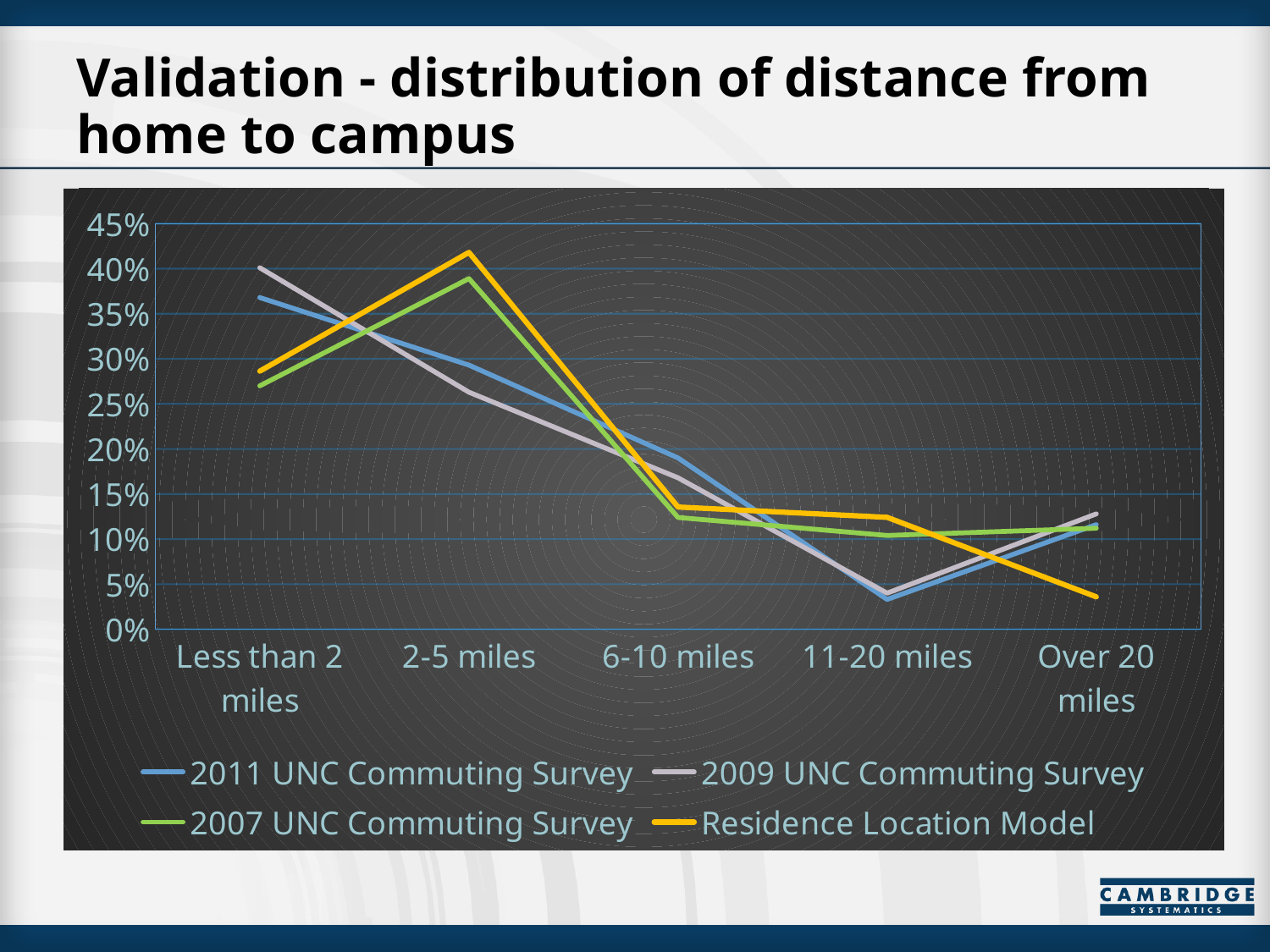
For which distance category is the Residence Location Model value lowest? Over 20 miles Is the 2011 UNC Commuting Survey value for 11-20 miles greater or less than 10%? less For which distance category is the Residence Location Model value highest? 2-5 miles What kind of chart is shown on the slide? line chart How many series does the legend list? 4 How many distance categories are shown on the x axis? 5 For which distance category is the 2009 UNC Commuting Survey value highest? Less than 2 miles Is the Residence Location Model value for Over 20 miles greater or less than 10%? less At 2-5 miles, which is larger: the Residence Location Model or the 2011 UNC Commuting Survey? Residence Location Model Is the 2009 UNC Commuting Survey value for Less than 2 miles greater or less than 35%? greater At Less than 2 miles, which is larger: the 2009 UNC Commuting Survey or the 2007 UNC Commuting Survey? 2009 UNC Commuting Survey Does the 2011 UNC Commuting Survey line rise or fall from Less than 2 miles to 11-20 miles? fall